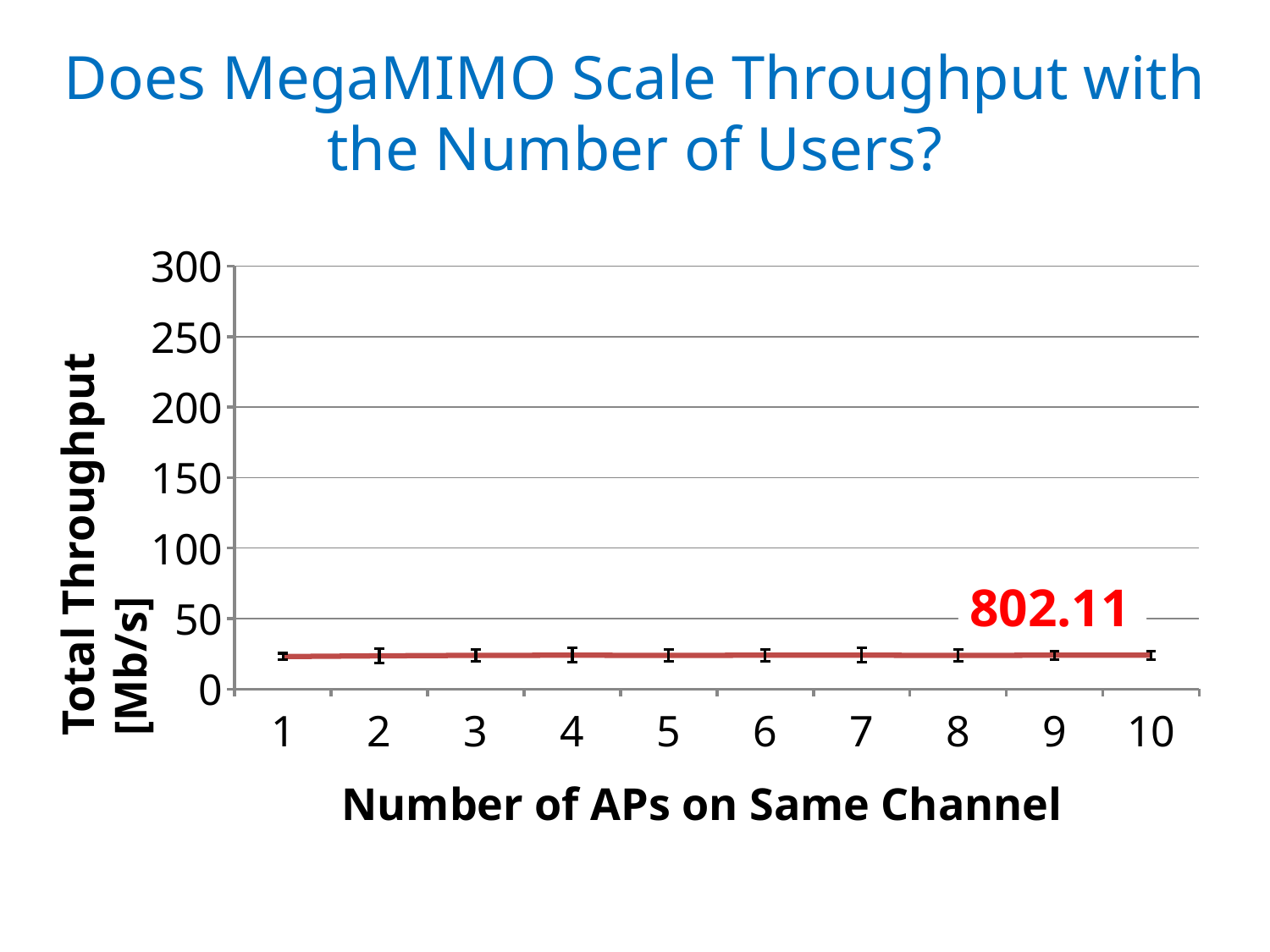
Is the value for 10 APs on the same channel greater or less than 50? less Is the value for 5 APs on the same channel greater or less than 100? less What kind of chart is shown on the slide? line chart Is the value for 1 AP on the same channel greater or less than 50? less What is the title of the x axis? Number of APs on Same Channel What is the highest value shown on the y axis? 300 Does the 802.11 throughput rise, fall, or stay roughly flat as the number of APs increases from 1 to 10? stays roughly flat How many data points are plotted along the x axis? 10 What is the label of the plotted series? 802.11